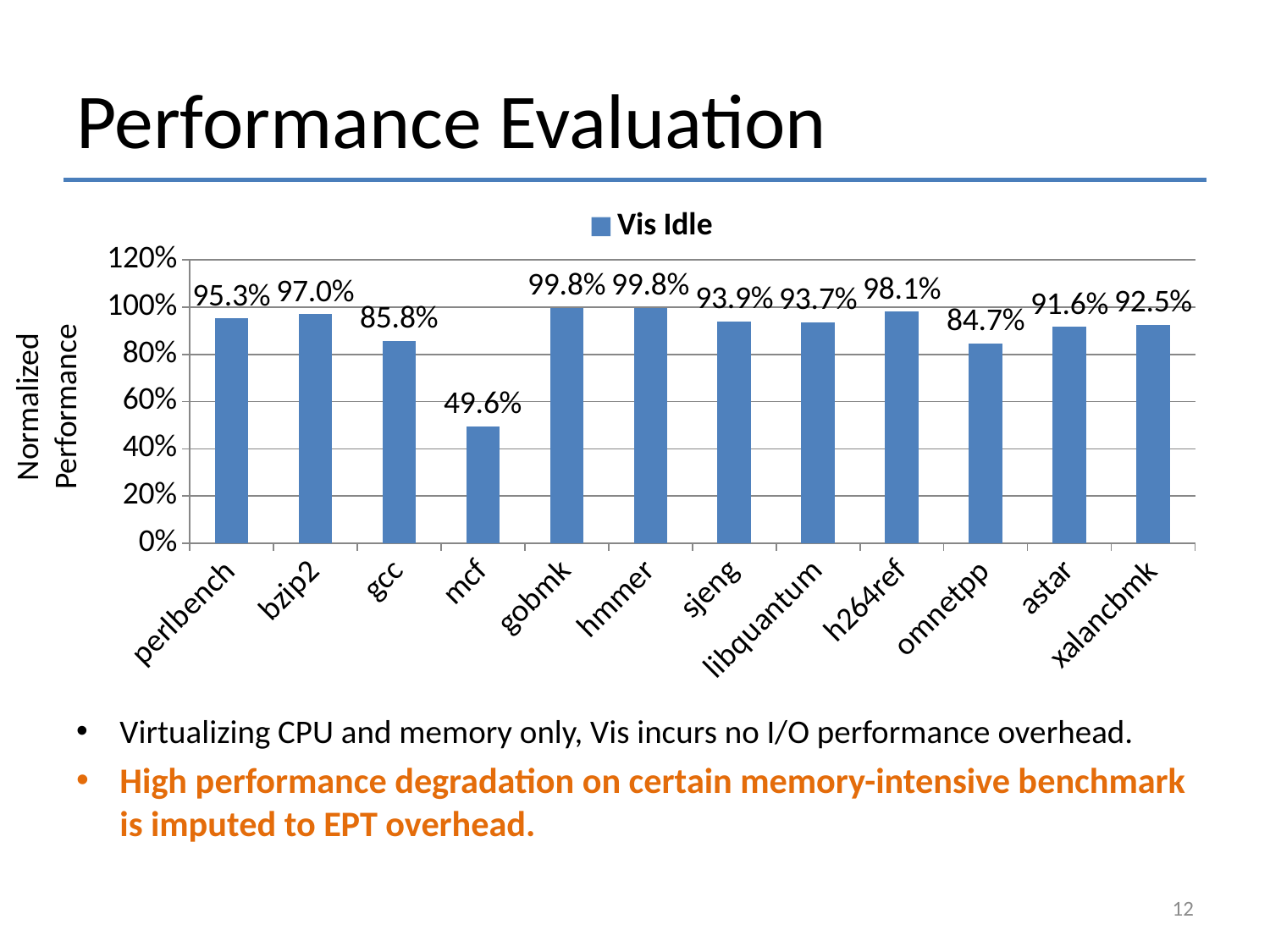
What is the difference in normalized performance between gobmk and mcf? 50.2 percentage points What is the normalized performance value for omnetpp? 84.7% How many series does the legend list? 1 What is the difference in normalized performance between h264ref and omnetpp? 13.4 percentage points What is the normalized performance value for mcf? 49.6% What is the normalized performance value for h264ref? 98.1% Which has a higher normalized performance, perlbench or gcc? perlbench How many benchmarks are shown on the x axis? 12 Is the value for mcf greater or less than 60%? less Which benchmark has the lowest normalized performance? mcf What kind of chart is shown on the slide? bar chart What is the normalized performance value for xalancbmk? 92.5%